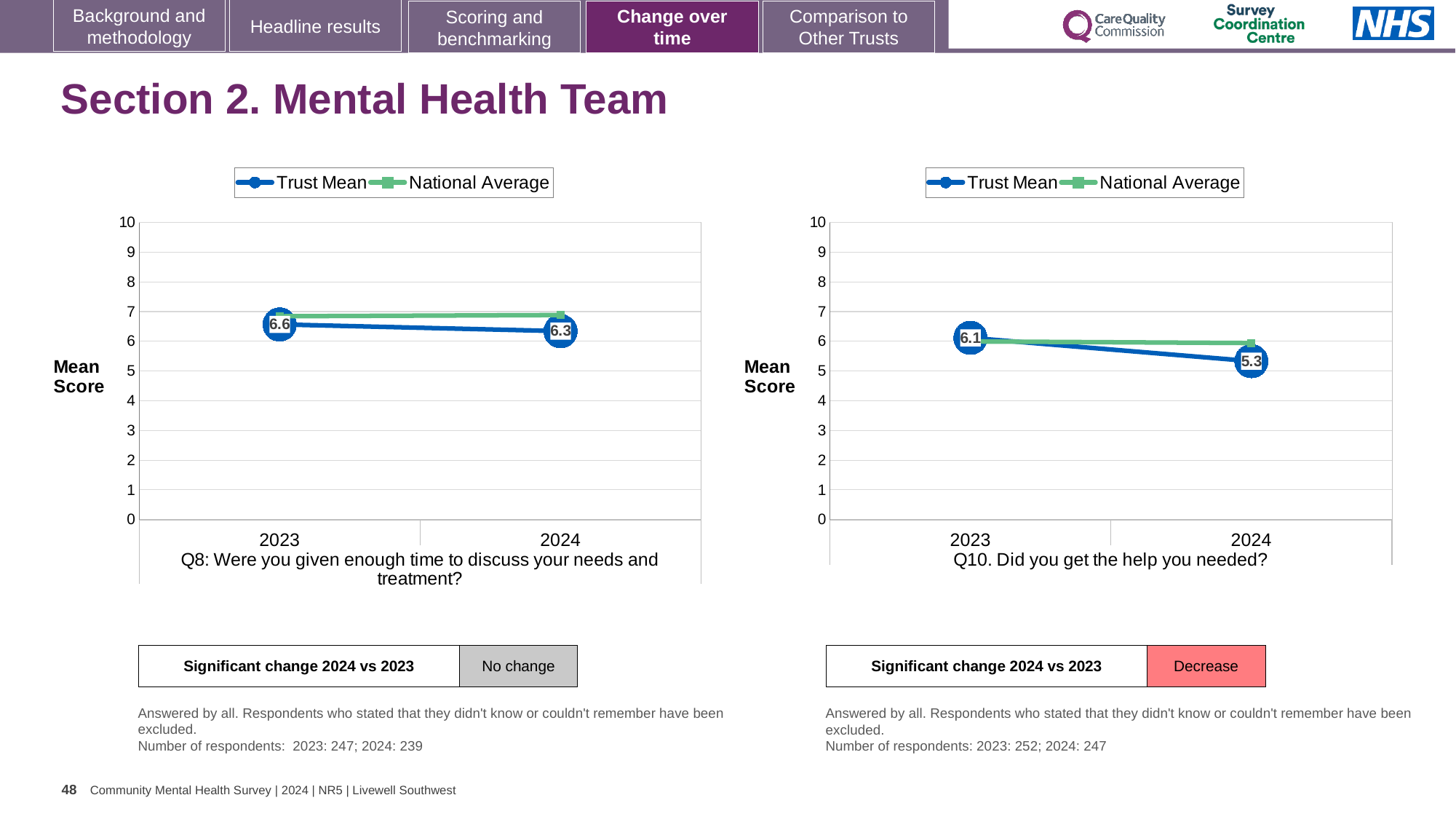
What kind of chart is the Q8 chart on the left? line chart In the Q8 chart on the left, what is the Trust Mean for 2023? 6.6 In the Q10 chart on the right, what is the Trust Mean for 2023? 6.1 In the Q8 chart on the left, is the National Average for 2023 greater or less than 6? greater In the Q10 chart on the right, by how much did the Trust Mean fall from 2023 to 2024? 0.8 In the Q10 chart on the right, which is larger in 2024: the Trust Mean or the National Average? National Average In the Q8 chart on the left, what is the Trust Mean for 2024? 6.3 In the Q10 chart on the right, does the Trust Mean rise or fall from 2023 to 2024? fall How many years are plotted on the x axis of the Q8 chart on the left? 2 In the Q8 chart on the left, what is the difference between the Trust Mean in 2023 and in 2024? 0.3 How many series does the legend of the Q10 chart on the right list? 2 In the Q10 chart on the right, what is the Trust Mean for 2024? 5.3